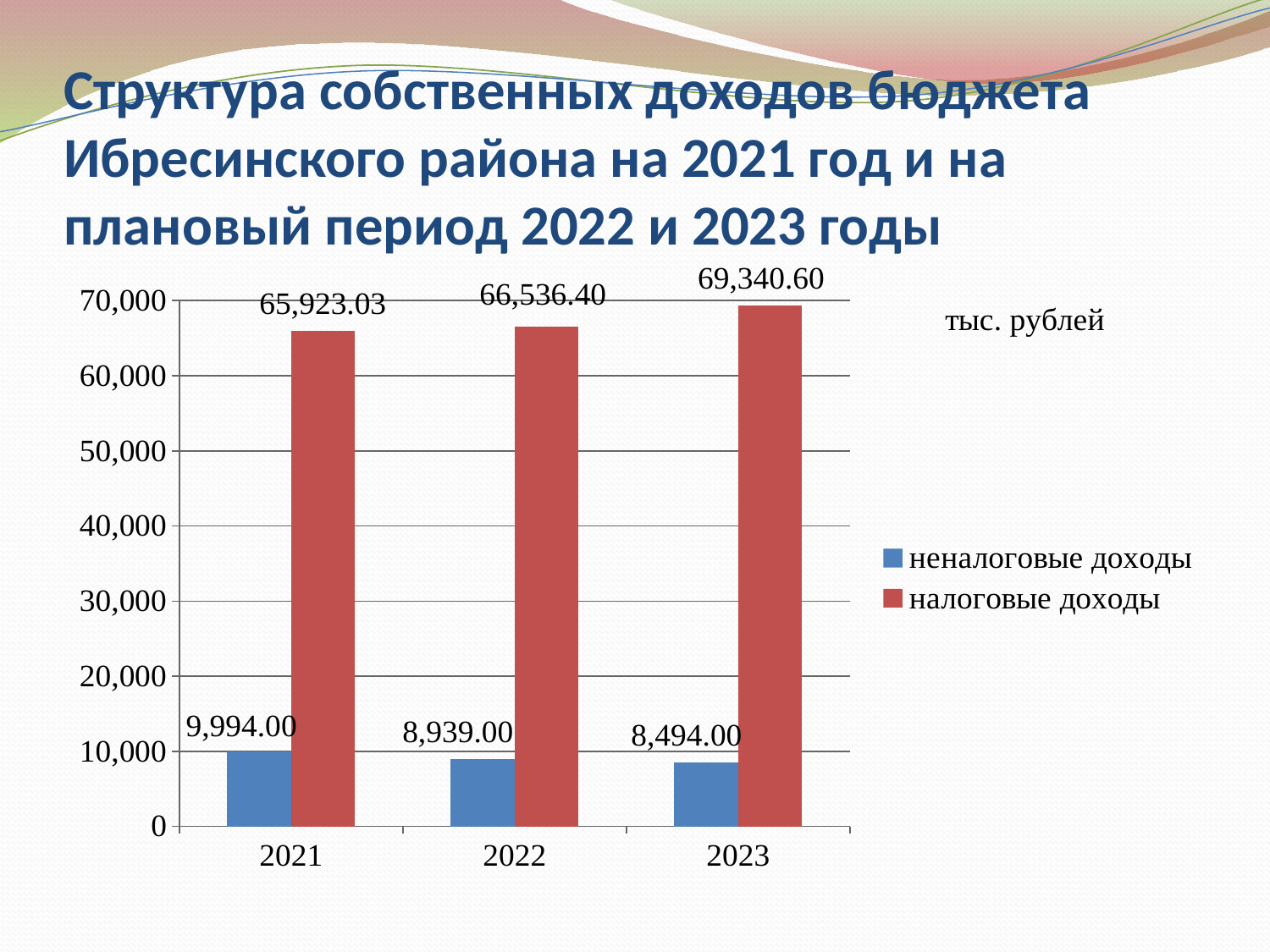
What is the value for неналоговые доходы in 2023? 8,494.00 In which year is неналоговые доходы lowest? 2023 What is the value for налоговые доходы in 2021? 65,923.03 How many years are shown on the x axis? 3 What kind of chart is shown on the slide? bar chart Is the value for неналоговые доходы in 2021 greater or less than 10,000? less Which is larger in 2022: налоговые доходы or неналоговые доходы? налоговые доходы How many series does the legend list? 2 What is the value for налоговые доходы in 2022? 66,536.40 In which year is налоговые доходы highest? 2023 What is the difference between налоговые доходы in 2023 and in 2022? 2,804.20 What is the difference between неналоговые доходы in 2021 and in 2023? 1,500.00